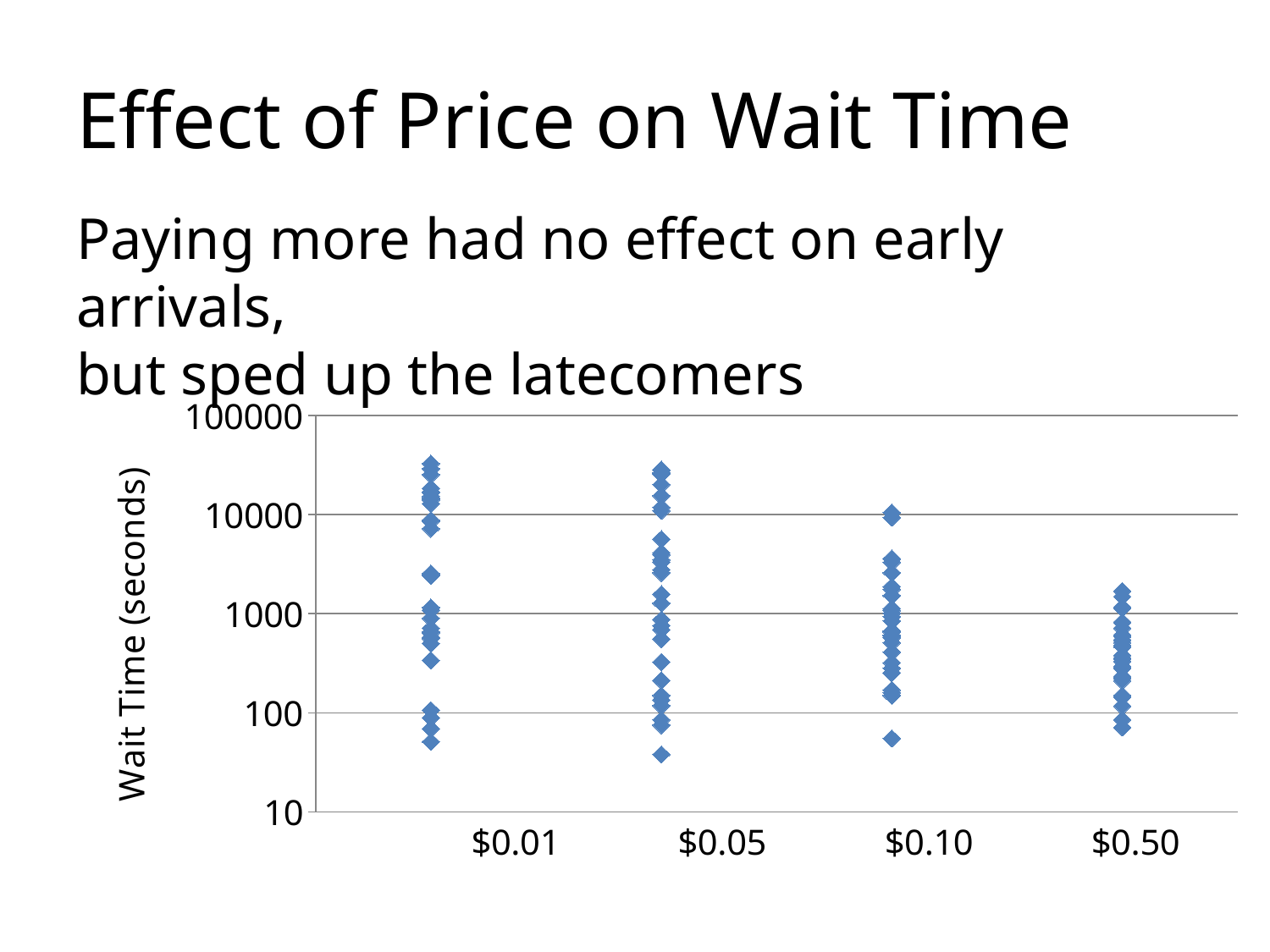
Is the highest wait time for $0.50 greater or less than 10000 seconds? less Which is larger, the maximum wait time for $0.05 or for $0.50? $0.05 Is the highest wait time for $0.10 greater or less than 1000 seconds? greater Which price category has the lowest maximum wait time? $0.50 Does the maximum wait time rise or fall as the price increases along the x axis? fall Is the highest wait time for $0.01 greater or less than 10000 seconds? greater What kind of chart is shown on the slide? scatter chart What is the label of the y axis? Wait Time (seconds) How many price categories are shown on the x axis? 4 What is the highest value shown on the y axis? 100000